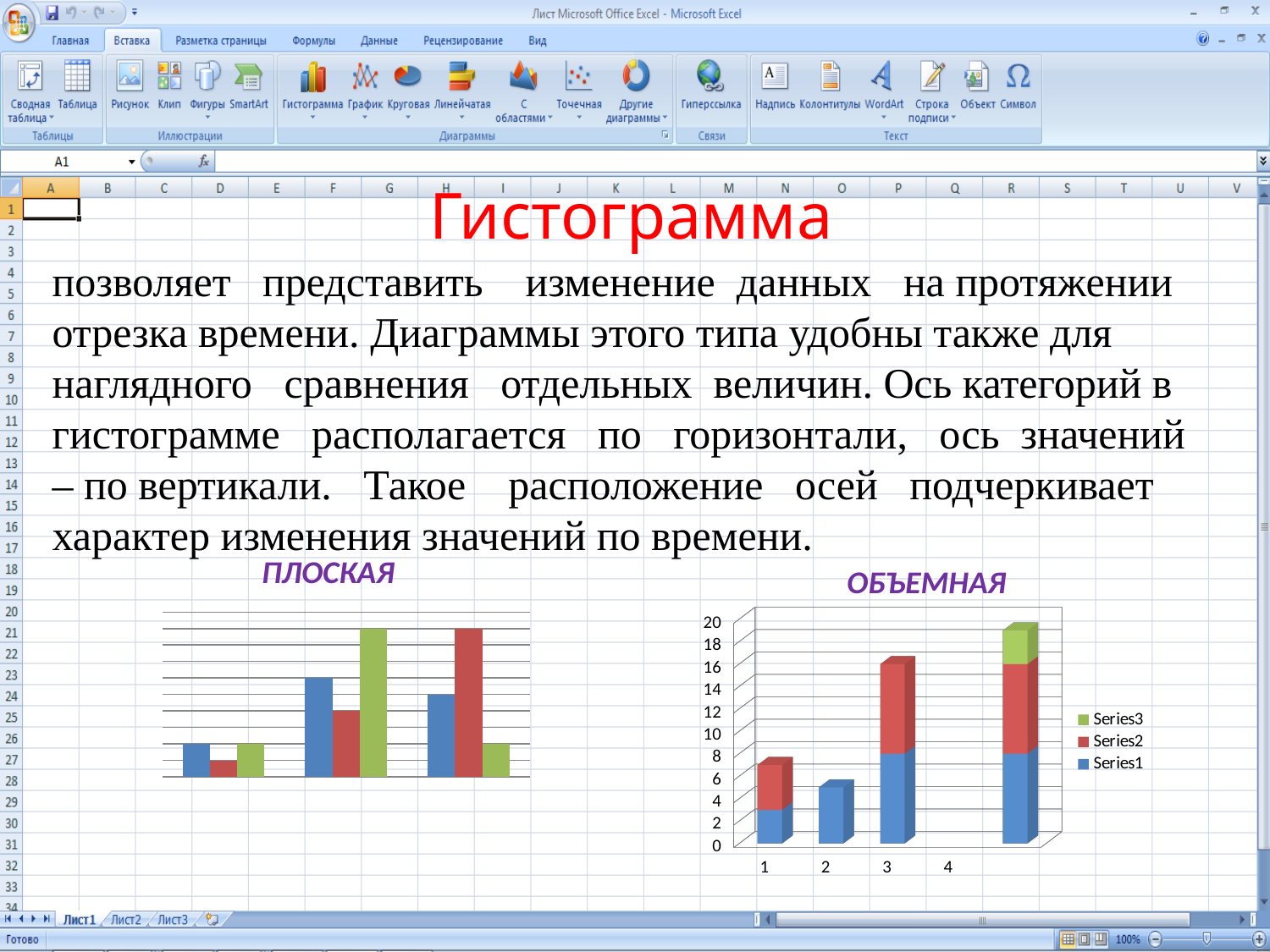
In the chart titled ОБЪЕМНАЯ, what colour represents Series3 in the legend? green What kind of chart is the chart titled ОБЪЕМНАЯ? bar chart In the chart titled ОБЪЕМНАЯ, which category has the shortest stacked bar? 2 In the chart titled ОБЪЕМНАЯ, which category contains only one series? 2 In the chart titled ОБЪЕМНАЯ, how many series does the legend list? 3 What kind of chart is the chart titled ПЛОСКАЯ? bar chart In the chart titled ОБЪЕМНАЯ, how many categories are shown on the horizontal axis? 4 In the chart titled ОБЪЕМНАЯ, is the total height of the stacked bar for category 2 greater or less than 8? less In the chart titled ПЛОСКАЯ, how many groups of bars are there? 3 In the chart titled ОБЪЕМНАЯ, is the stacked bar for category 3 taller or shorter than the stacked bar for category 1? taller